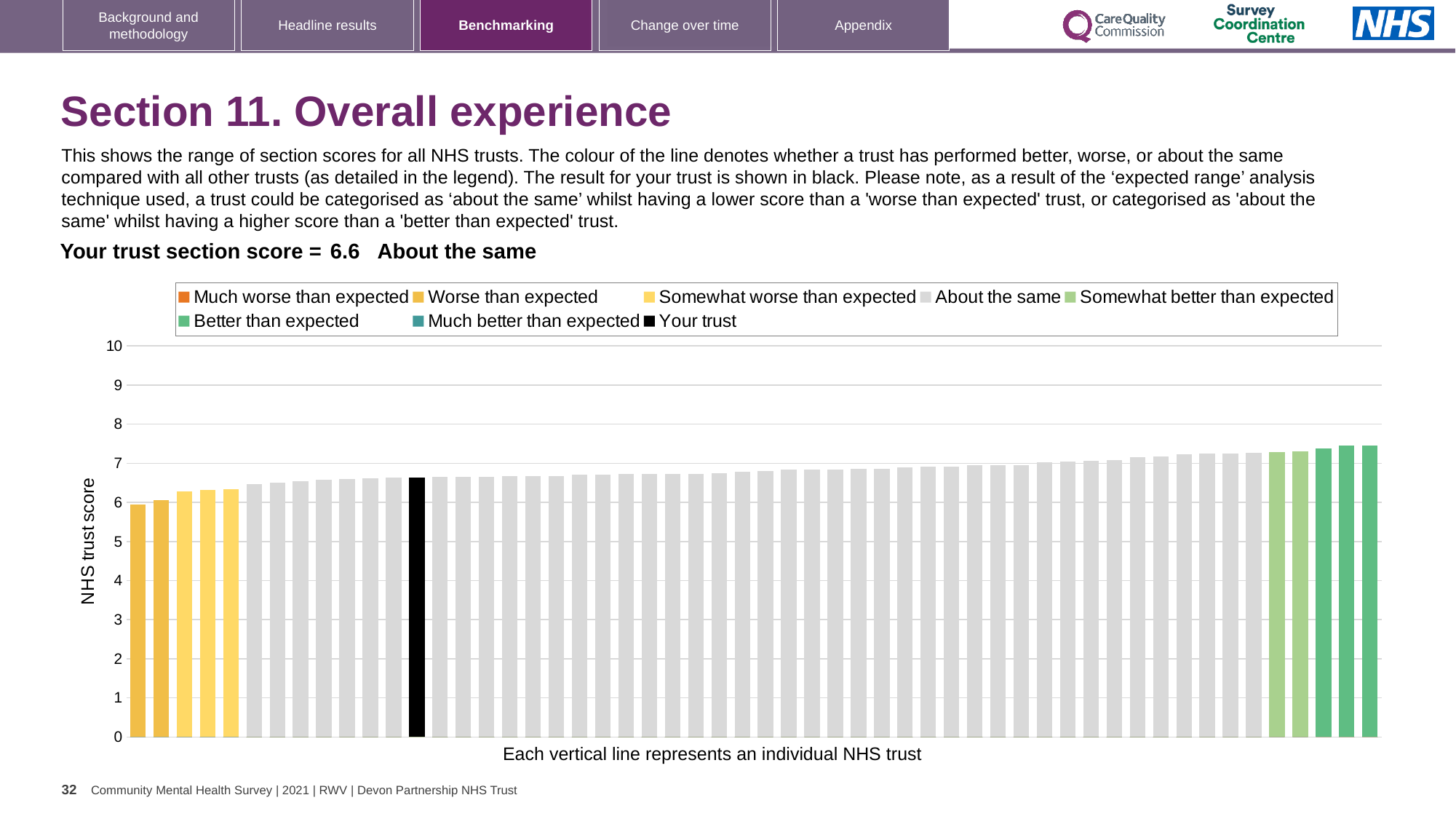
Which is larger, the value for your trust (black bar) or the value of the rightmost bar? the rightmost bar What is the label on the vertical axis of the chart? NHS trust score Do the bar values rise or fall from left to right along the x axis? rise How many entries does the chart legend list? 8 What is the section score for your trust shown on the slide? 6.6 Is the value for your trust greater or less than 7? less Is the value for your trust greater or less than 6? greater What kind of chart is shown on the slide? bar chart What colour is used for the bar representing your trust? black Which category is your trust placed in for this section? About the same Is the value of the tallest bar on the right of the chart greater or less than 7? greater